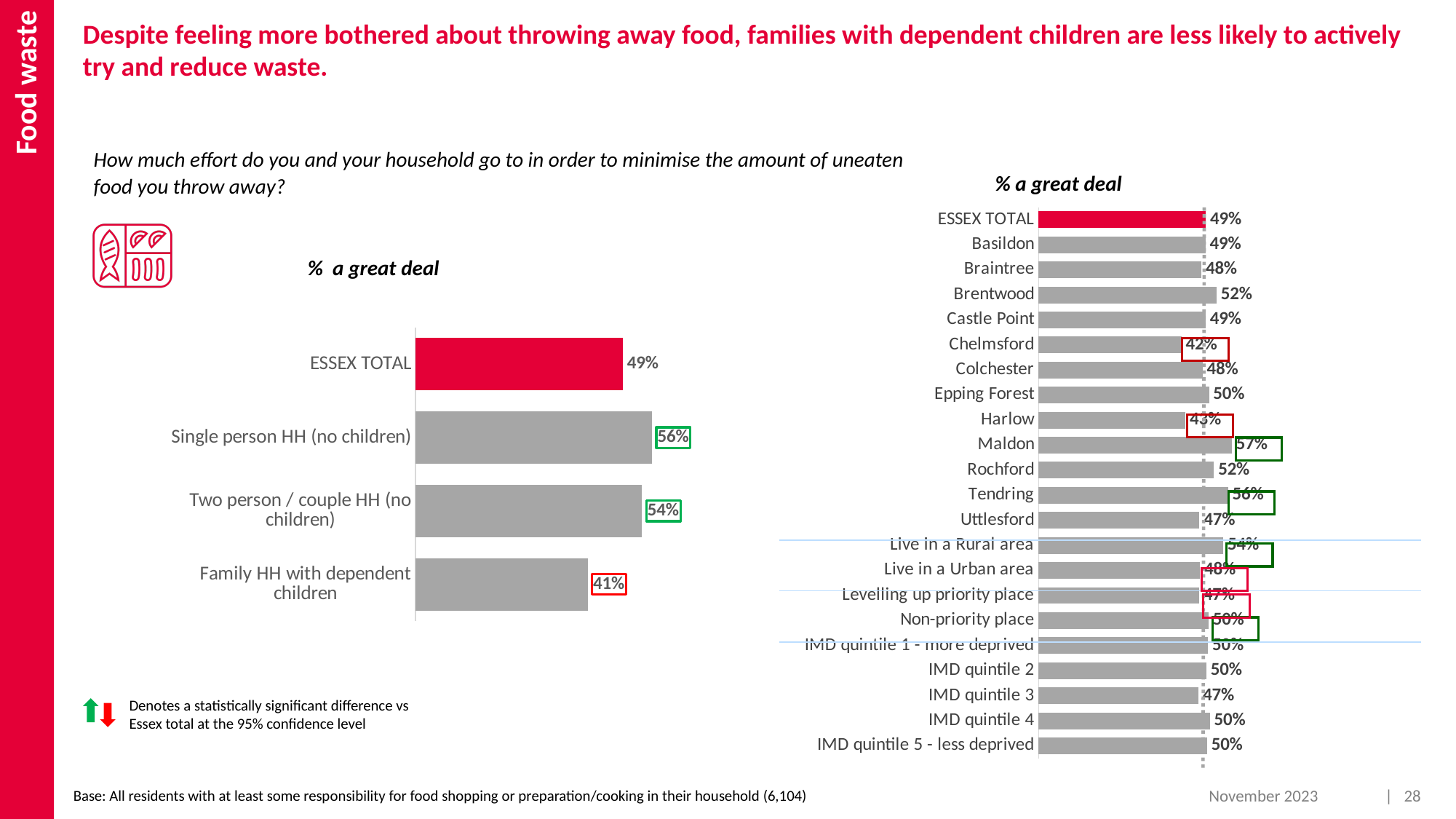
On the right chart, what is the value for Chelmsford? 42% On the left chart, how many categories are plotted? 4 On the left chart, which category has the lowest value? Family HH with dependent children What type of chart is the left chart? Bar chart On the right chart, which is larger, Brentwood or Harlow? Brentwood On the right chart, what is the difference between Tendring and Uttlesford? 9 percentage points On the right chart, what is the value for Maldon? 57% On the left chart, what percentage of Family HH with dependent children say they go to a great deal of effort? 41% On the right chart, which district has the highest value? Maldon On the left chart, what is the value for Single person HH (no children)? 56% On the left chart, what is the difference between Single person HH (no children) and Family HH with dependent children? 15 percentage points On the left chart, which bar is coloured red rather than grey? ESSEX TOTAL